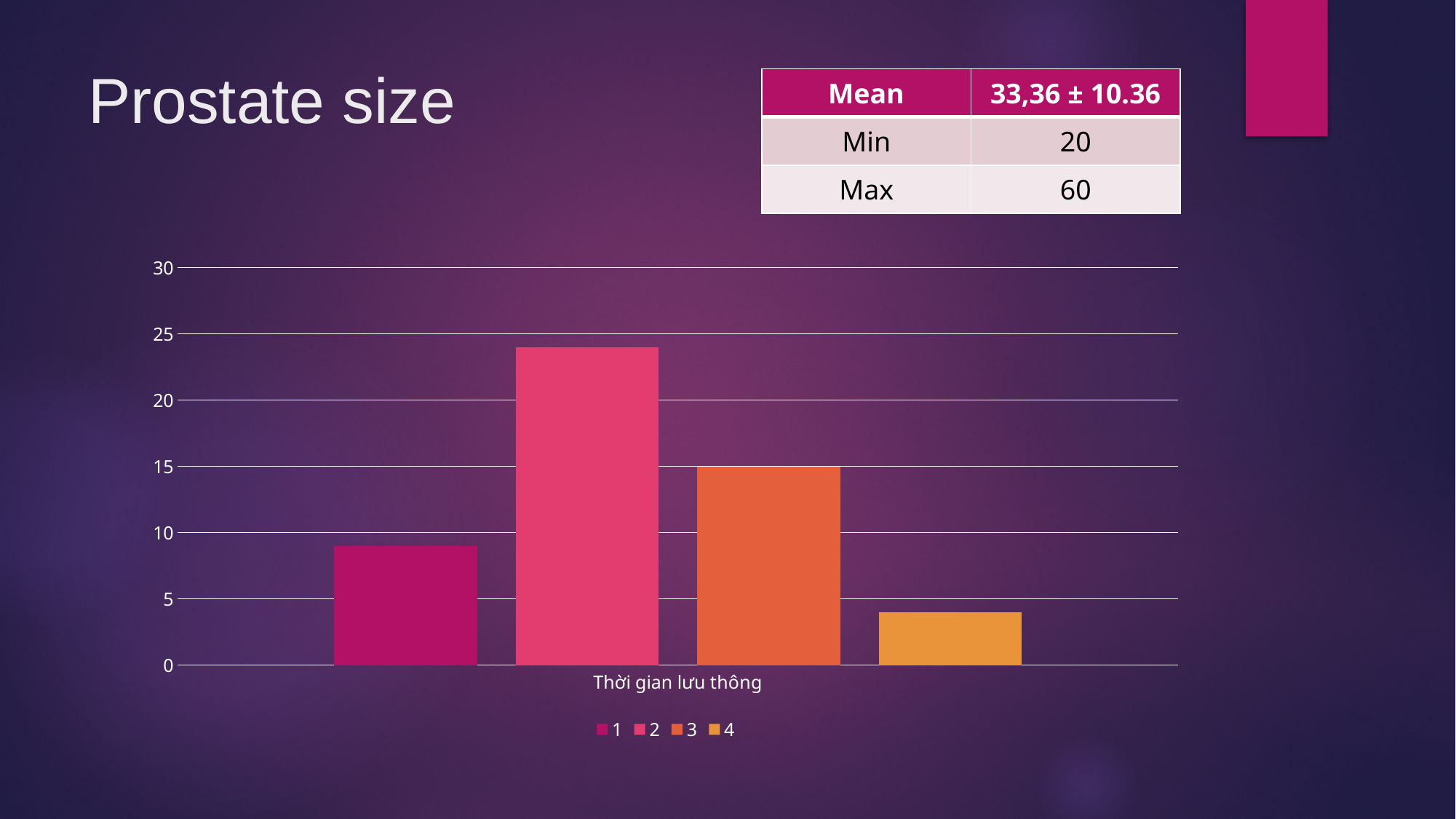
How many categories are shown on the x axis of the chart? 1 Is the value for series 2 greater or less than 20? greater How many series does the chart legend list? 4 Which series has the shortest bar in the chart? 4 Is the value for series 4 greater or less than 5? less What is the value for series 3 in the chart? 15 What is the category label shown on the x axis of the chart? Thời gian lưu thông Which is larger in the chart, the bar for series 1 or the bar for series 3? 3 Is the value for series 1 greater or less than 10? less What kind of chart is shown on the slide? bar chart Which series has the tallest bar in the chart? 2